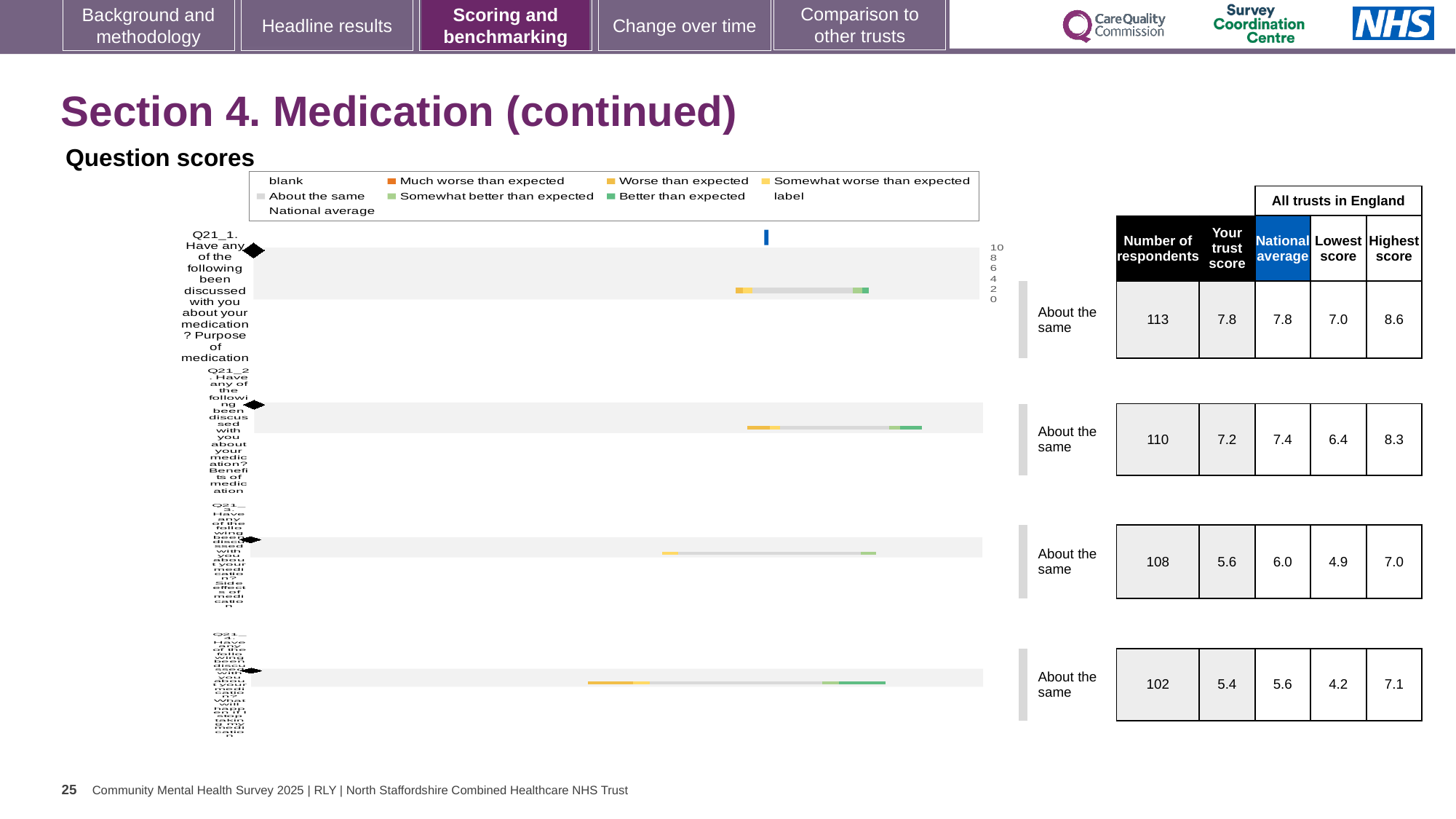
What is the highest score among all trusts in England for Q21_2 (Benefits of medication)? 8.3 For Q21_3 (Side effects of medication), which is larger: the trust score or the national average? National average What is the trust score for Q21_1 (Purpose of medication)? 7.8 Which question has the highest trust score? Q21_1 (Purpose of medication) What is the national average for Q21_4 (What might happen if stop taking medication)? 5.6 Which question has the lowest trust score? Q21_4 (What might happen if stop taking medication) What kind of chart is used to show the question scores? bar chart What colour represents 'Much worse than expected' in the legend? Orange What benchmark category is shown for all four questions? About the same How many respondents answered Q21_3 (Side effects of medication)? 108 How many question rows are plotted in the chart? 4 What is the difference between the national average and the trust score for Q21_2 (Benefits of medication)? 0.2